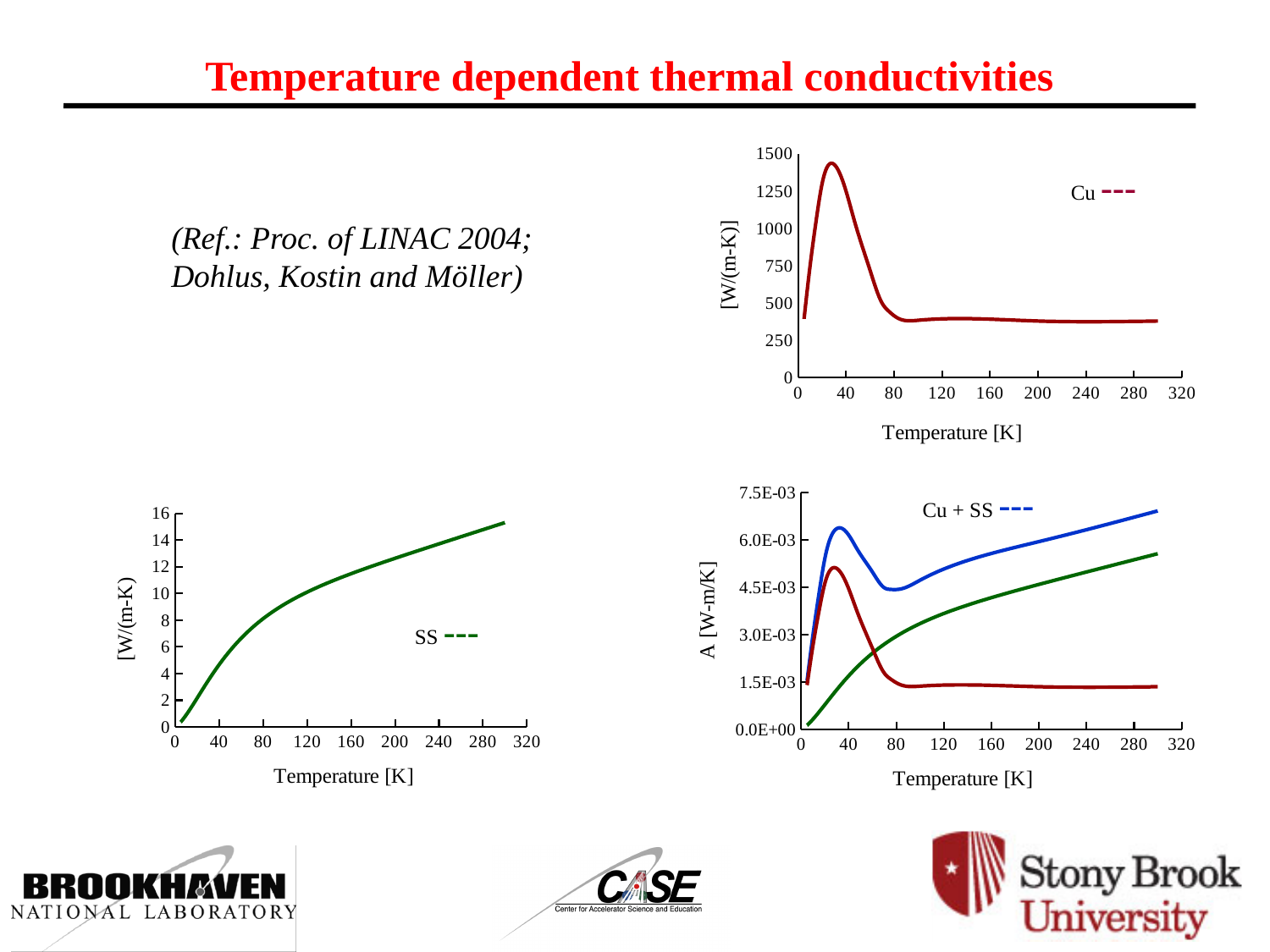
In the bottom-left SS chart, is the value at 160 K greater or less than 10? greater In the top-right Cu chart, is the value at 40 K greater or less than 1000? greater In the top-right Cu chart, is the value at 200 K greater or less than 500? less In the top-right Cu chart, does the curve rise or fall between 40 K and 80 K? fall What is the y-axis label of the bottom-right chart? A [W-m/K] In the bottom-right chart, how many lines are plotted? 3 In the bottom-left SS chart, do the values rise or fall as temperature increases from 0 to 300 K? rise What kind of chart is the top-right chart labelled Cu? Line chart In the bottom-right chart, which line is higher at 300 K, the blue line or the green line? The blue line